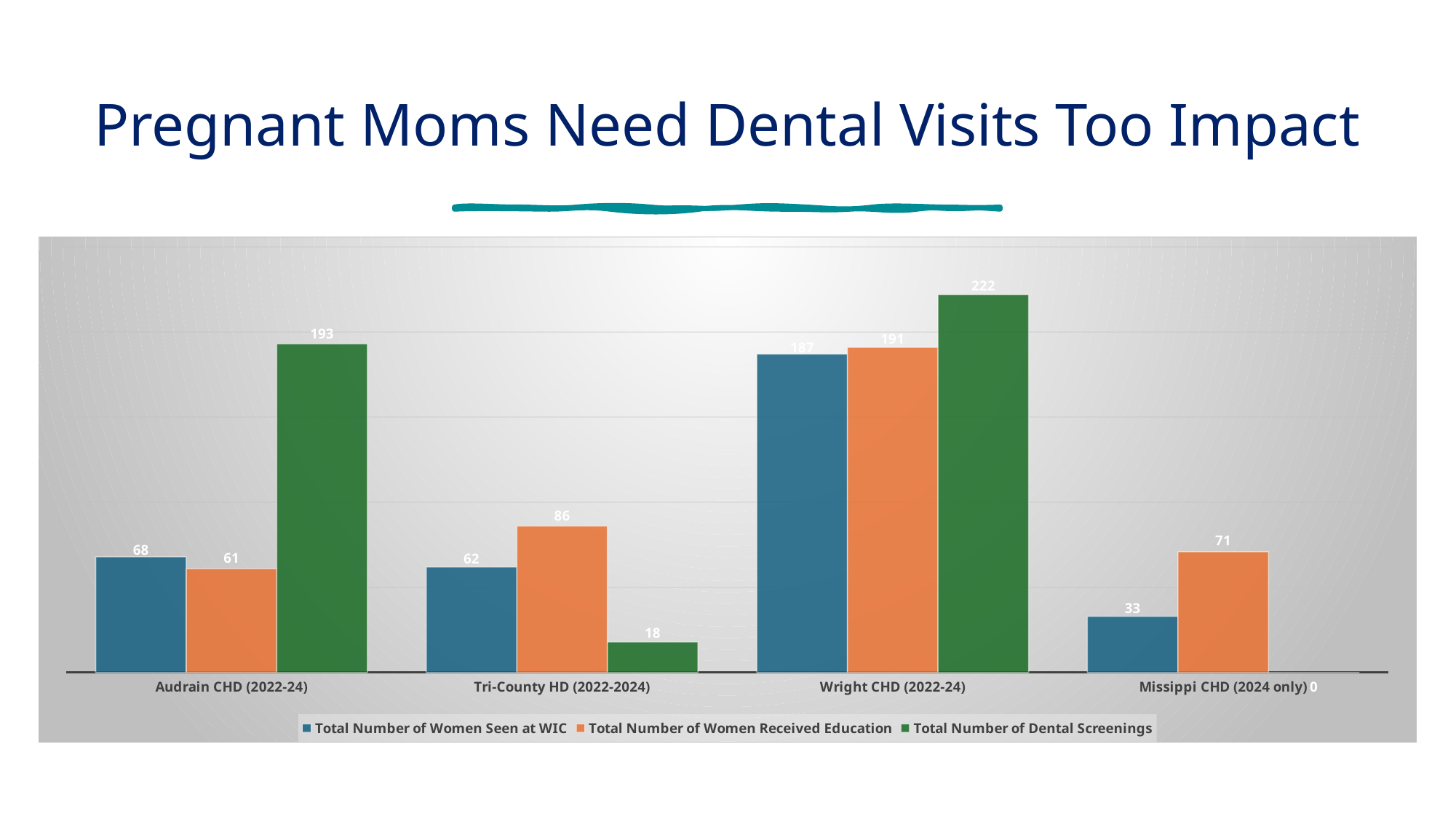
What is the Total Number of Dental Screenings for Wright CHD (2022-24)? 222 What kind of chart is shown on the slide? Bar chart How many categories are shown on the x axis? 4 What is the Total Number of Women Seen at WIC for Audrain CHD (2022-24)? 68 Which is larger for Tri-County HD (2022-2024): Total Number of Women Received Education or Total Number of Dental Screenings? Total Number of Women Received Education How many series does the legend list? 3 Which category has the highest Total Number of Dental Screenings? Wright CHD (2022-24) What is the Total Number of Dental Screenings for Missippi CHD (2024 only)? 0 What is the difference between the Total Number of Dental Screenings and the Total Number of Women Seen at WIC for Audrain CHD (2022-24)? 125 What colour represents the Total Number of Dental Screenings series? Green What is the Total Number of Women Received Education for Tri-County HD (2022-2024)? 86 Which category has the lowest Total Number of Women Seen at WIC? Missippi CHD (2024 only)